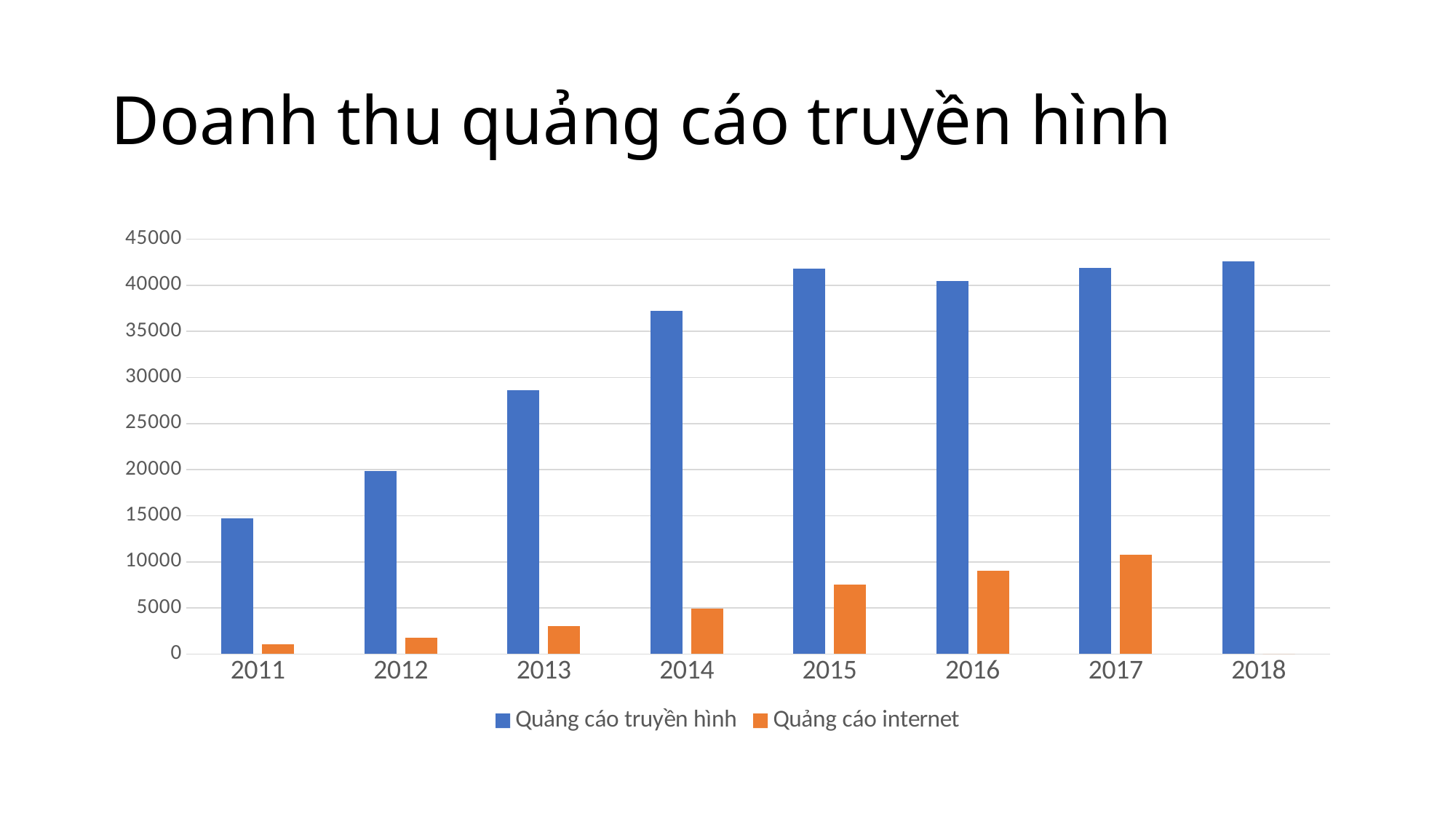
What is the title of the slide? Doanh thu quảng cáo truyền hình What kind of chart is shown on the slide? bar chart How many series does the legend list? 2 Which year has the lowest value for Quảng cáo truyền hình? 2011 Is the value for Quảng cáo truyền hình in 2013 greater or less than 25000? greater Which is larger, Quảng cáo truyền hình in 2013 or in 2014? 2014 Is the value for Quảng cáo internet in 2017 greater or less than 10000? greater Is the value for Quảng cáo internet in 2016 greater or less than 10000? less Do the values for Quảng cáo internet rise or fall from 2011 to 2017? rise How many years are shown on the x axis? 8 Which year has the highest value for Quảng cáo internet? 2017